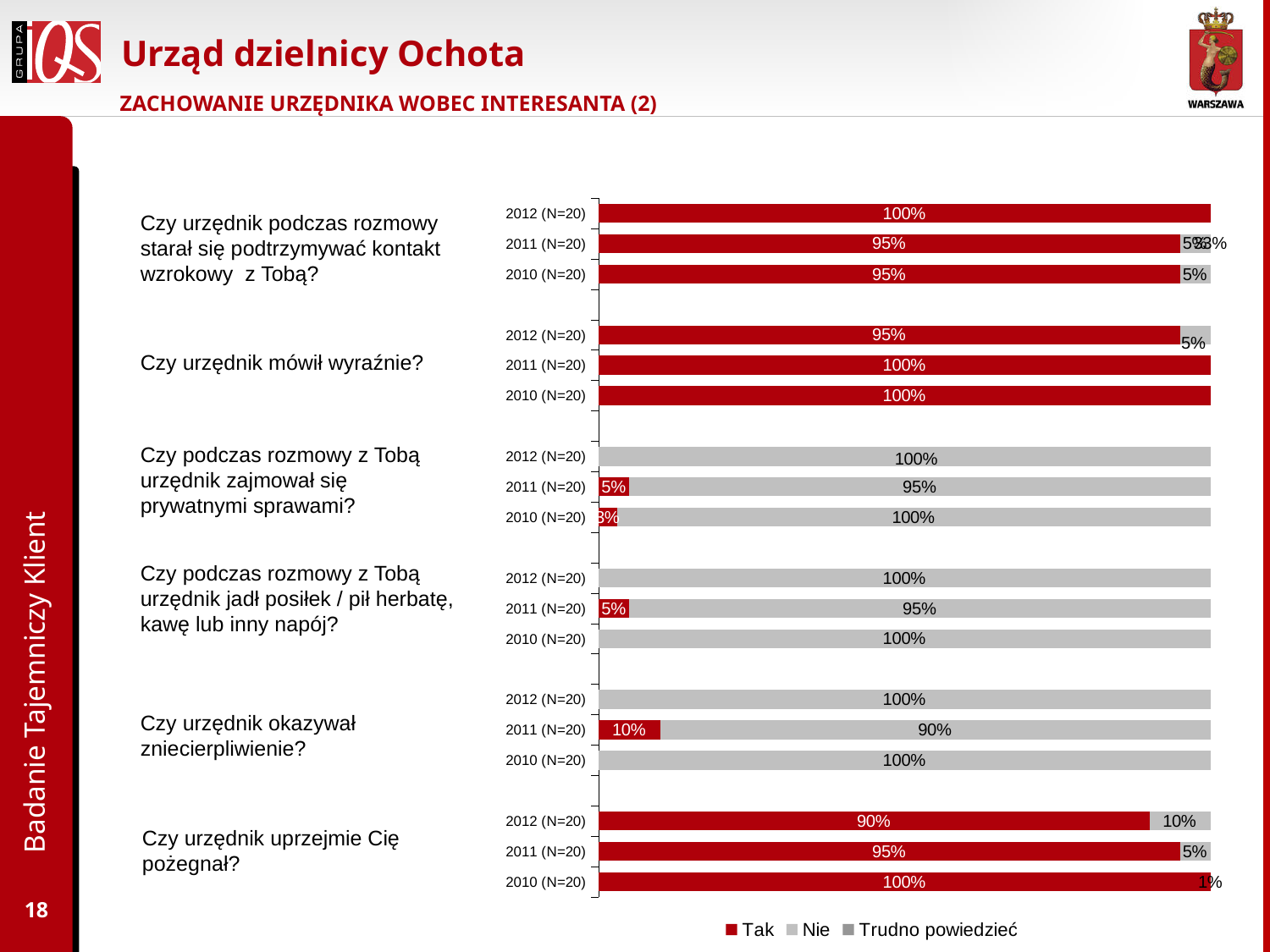
For the question 'Czy urzędnik okazywał zniecierpliwienie?', what is the 'Tak' value for 2011 (N=20)? 10% For the question 'Czy urzędnik uprzejmie Cię pożegnał?', what is the 'Nie' value for 2012 (N=20)? 10% How many series does the chart legend list? 3 For the question 'Czy urzędnik mówił wyraźnie?', what is the 'Tak' value for 2012 (N=20)? 95% For the question 'Czy urzędnik okazywał zniecierpliwienie?', what is the 'Nie' value for 2011 (N=20)? 90% For the question 'Czy urzędnik uprzejmie Cię pożegnał?', is the 'Tak' value for 2011 (N=20) larger or smaller than for 2012 (N=20)? Larger What type of chart is shown on the slide? Stacked bar chart For the question 'Czy urzędnik uprzejmie Cię pożegnał?', what is the difference between the 'Tak' values for 2010 (N=20) and 2012 (N=20)? 10% For the question 'Czy podczas rozmowy z Tobą urzędnik jadł posiłek / pił herbatę, kawę lub inny napój?', what is the 'Tak' value for 2011 (N=20)? 5% For the question 'Czy urzędnik podczas rozmowy starał się podtrzymywać kontakt wzrokowy z Tobą?', what is the 'Tak' value for 2012 (N=20)? 100% For the question 'Czy urzędnik uprzejmie Cię pożegnał?', which year has the highest 'Tak' value? 2010 (N=20) What are the legend entries of the chart? Tak, Nie, Trudno powiedzieć